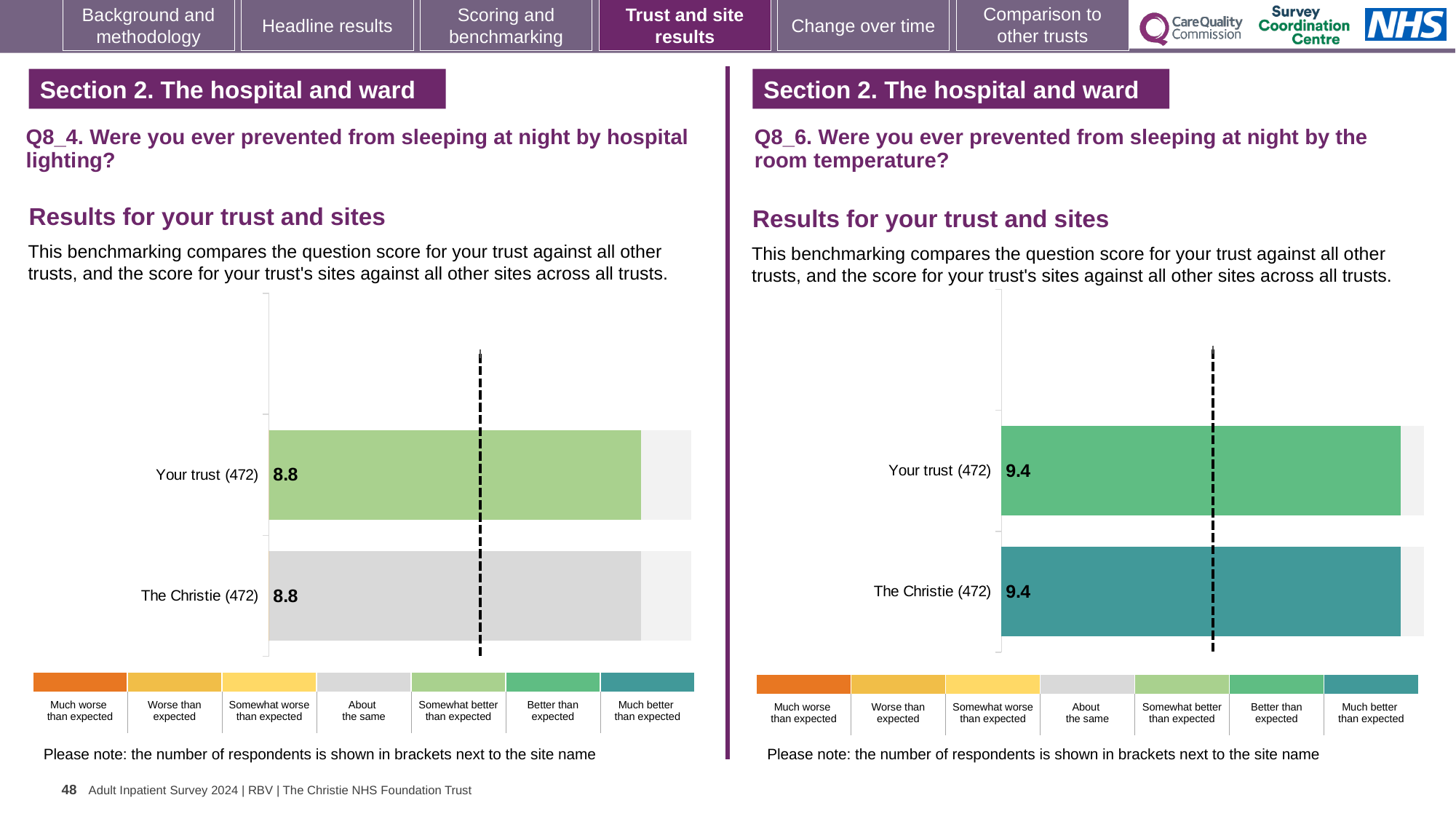
In the Q8_4 hospital lighting chart, what is the score for Your trust (472)? 8.8 What kind of chart is used for the Q8_6 room temperature results? Bar chart How many categories are listed in the colour key below the Q8_4 hospital lighting chart? 7 In the Q8_6 room temperature chart, what is the score for Your trust (472)? 9.4 In the Q8_4 hospital lighting chart, what is the difference between the scores for Your trust and The Christie? 0.0 In the Q8_6 room temperature chart, what is the score for The Christie (472)? 9.4 In the Q8_4 hospital lighting chart, what is the score for The Christie (472)? 8.8 How many bars are plotted in the Q8_4 hospital lighting chart? 2 In the Q8_4 hospital lighting chart, how many respondents are shown in brackets for Your trust? 472 In the Q8_6 room temperature chart, which benchmark category does the colour of the Your trust bar correspond to in the key below the chart? Better than expected In the Q8_6 room temperature chart, what is the difference between the scores for Your trust and The Christie? 0.0 How many bars are plotted in the Q8_6 room temperature chart? 2